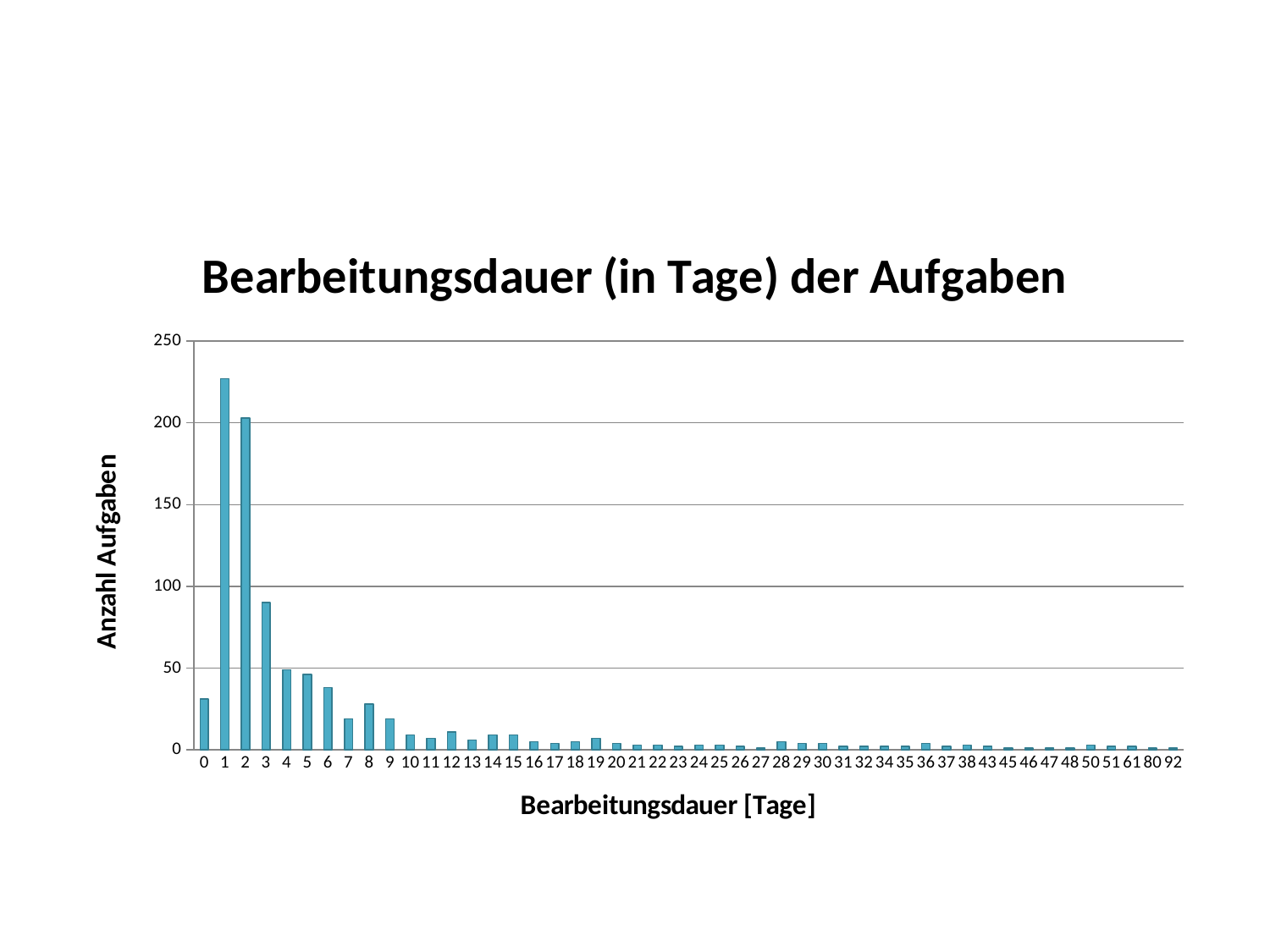
Is the value for Bearbeitungsdauer 3 greater or less than 100? less Is the value for Bearbeitungsdauer 3 greater or less than 50? greater Is the value for Bearbeitungsdauer 7 greater or less than 50? less Which has a higher Anzahl Aufgaben, Bearbeitungsdauer 1 or Bearbeitungsdauer 2? 1 What is the title of the chart? Bearbeitungsdauer (in Tage) der Aufgaben Which has a higher Anzahl Aufgaben, Bearbeitungsdauer 3 or Bearbeitungsdauer 4? 3 Which Bearbeitungsdauer category has the highest Anzahl Aufgaben? 1 What is the label of the vertical axis? Anzahl Aufgaben From Bearbeitungsdauer 1 to Bearbeitungsdauer 9, do the values generally rise or fall? fall What kind of chart is shown on the slide? bar chart